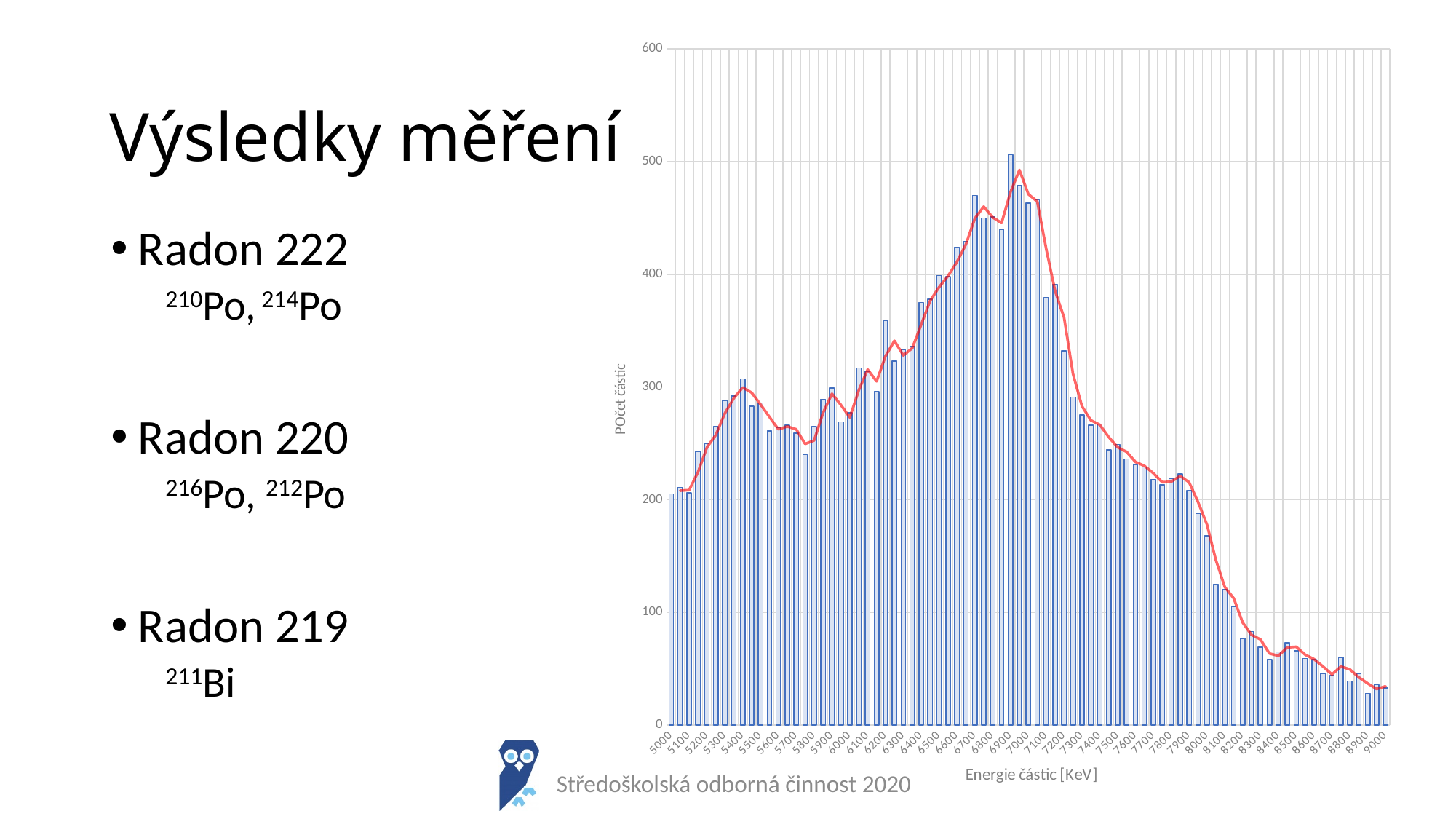
Is the value for 7500 greater or less than 200? greater Is the value for 8200 greater or less than 100? less Is the value for 8500 greater or less than 100? less Do the values rise or fall along the x axis from 7000 to 9000? fall What kind of chart is used for the blue series on the slide? bar chart What is the title of the vertical axis? Počet částic Which has the larger value, 5400 or 5000? 5400 Which has the larger value, 6900 or 8000? 6900 At which energy value on the x axis is the tallest bar? 6900